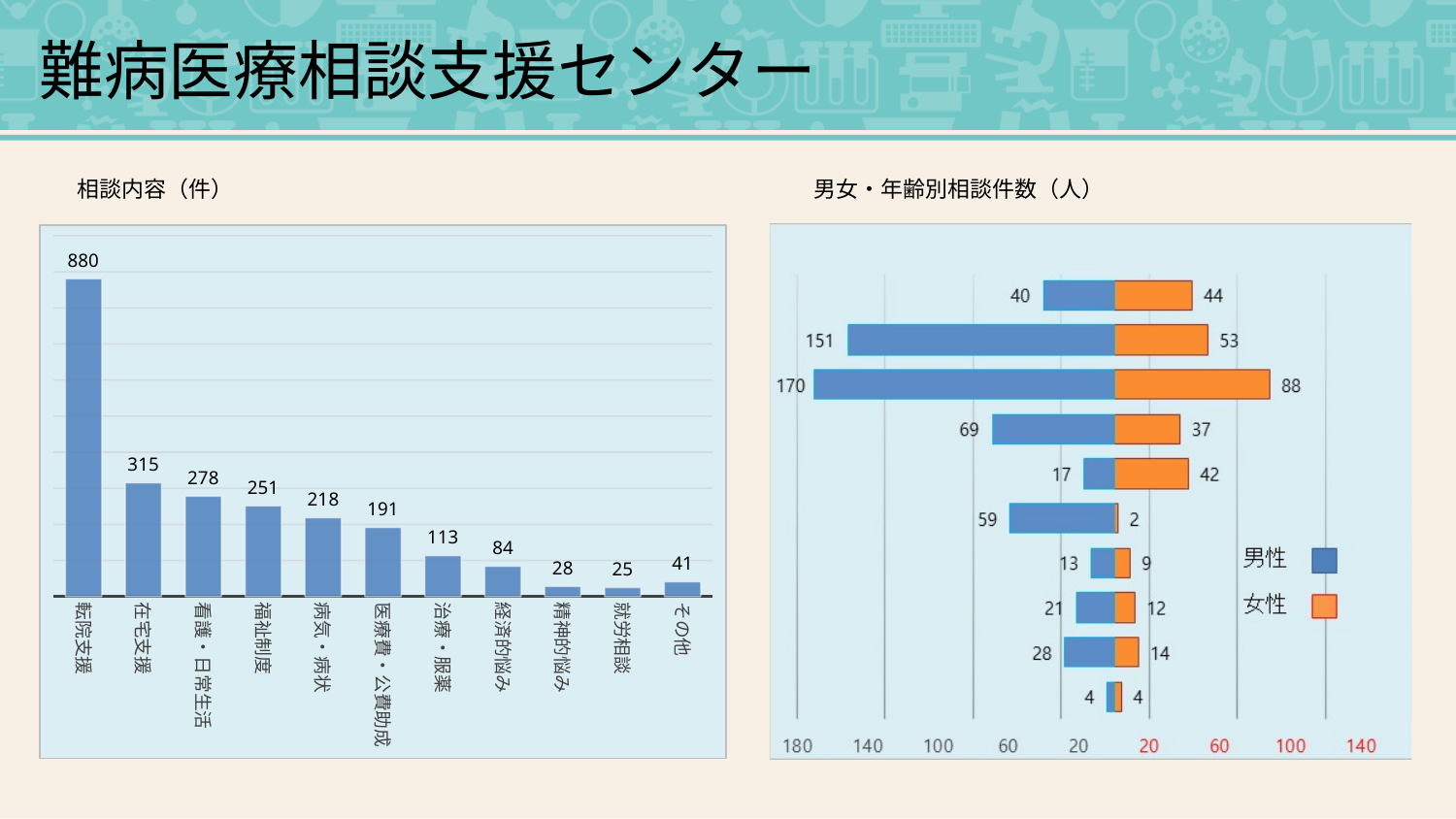
In the 相談内容（件） chart, what is the value for 在宅支援? 315 In the 男女・年齢別相談件数（人） chart, what is the largest 男性 value shown? 170 What kind of chart is the 相談内容（件） chart? bar chart In the 相談内容（件） chart, which category has the highest value? 転院支援 In the 相談内容（件） chart, which is larger, 経済的悩み or その他? 経済的悩み How many series does the legend of the 男女・年齢別相談件数（人） chart list? 2 How many categories are shown in the 相談内容（件） chart? 11 In the 相談内容（件） chart, what is the value for 転院支援? 880 In the 相談内容（件） chart, what is the value for 治療・服薬? 113 In the 相談内容（件） chart, what is the difference between 在宅支援 and 看護・日常生活? 37 In the 相談内容（件） chart, which category has the lowest value? 就労相談 In the 男女・年齢別相談件数（人） chart, what is the largest 女性 value shown? 88